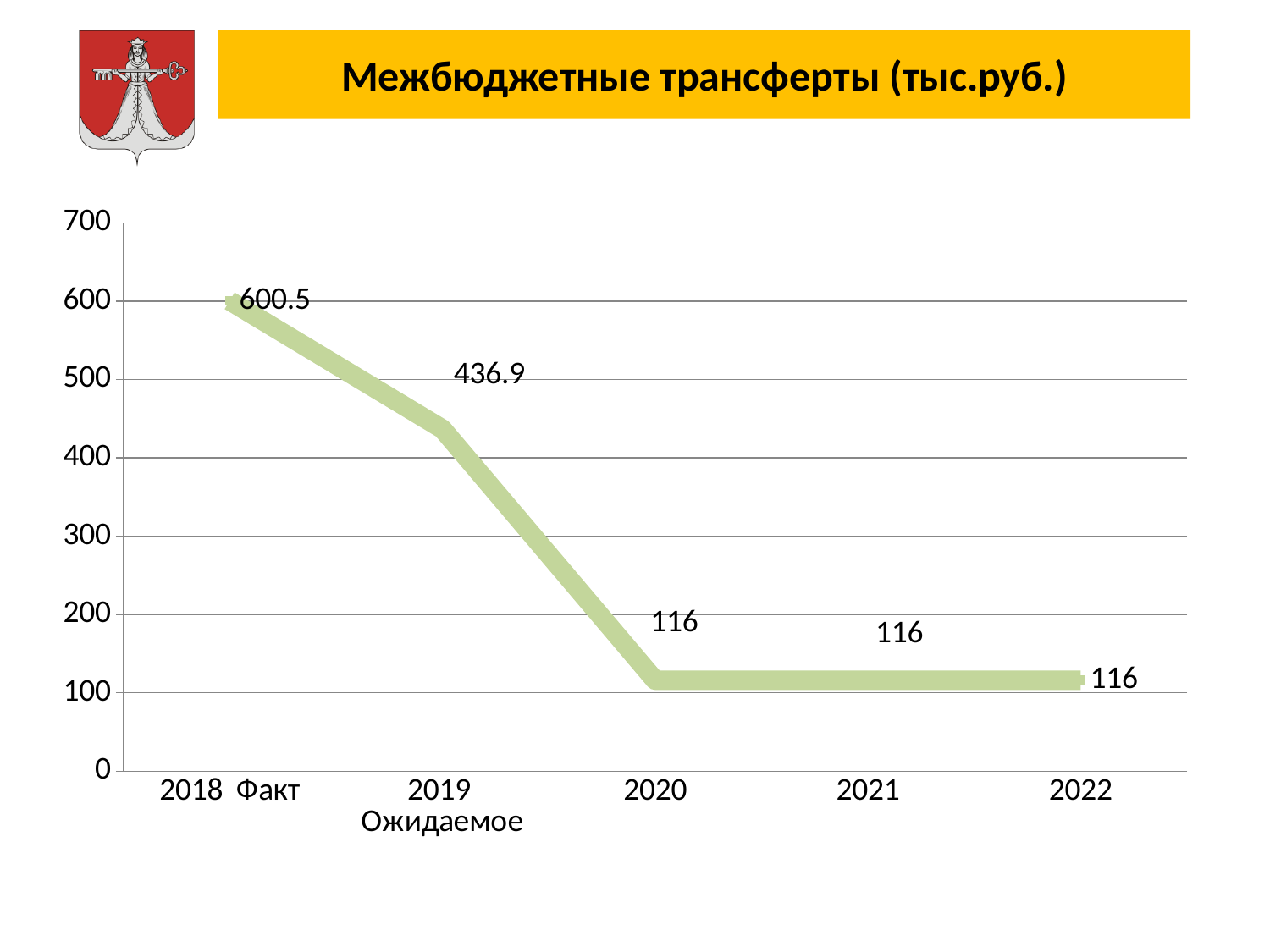
Do the values rise or fall from 2018 Факт to 2020? fall What is the difference between the values for 2019 Ожидаемое and 2020? 320.9 Which is larger, the value for 2019 Ожидаемое or the value for 2022? 2019 Ожидаемое What is the value for 2019 Ожидаемое? 436.9 What is the value for 2018 Факт? 600.5 What kind of chart is shown on the slide? line chart How many data points are plotted on the chart? 5 What is the difference between the values for 2018 Факт and 2019 Ожидаемое? 163.6 What is the value for 2021? 116 Is the value for 2020 greater or less than 200? less What is the title of the chart? Межбюджетные трансферты (тыс.руб.) Which category has the highest value? 2018 Факт